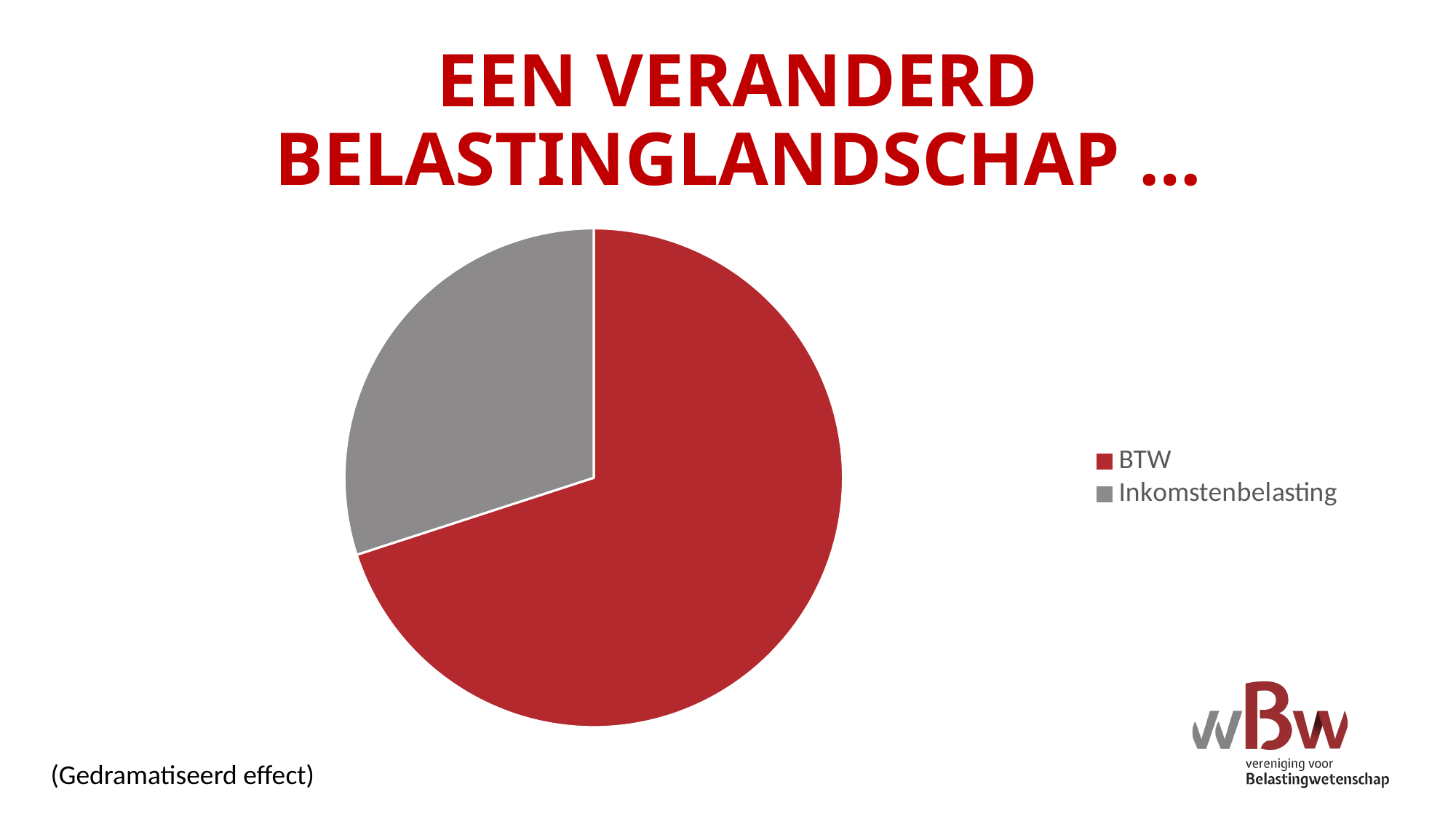
Does the BTW slice take up more or less than half of the pie? more Which category has the largest slice in the pie chart? BTW How many slices does the pie chart have? 2 Which slice is larger, BTW or Inkomstenbelasting? BTW Which category has the smallest slice in the pie chart? Inkomstenbelasting What colour is the BTW slice in the pie chart? red What kind of chart is shown on the slide? pie chart How many entries does the legend of the pie chart list? 2 Which category is shown in grey in the pie chart? Inkomstenbelasting